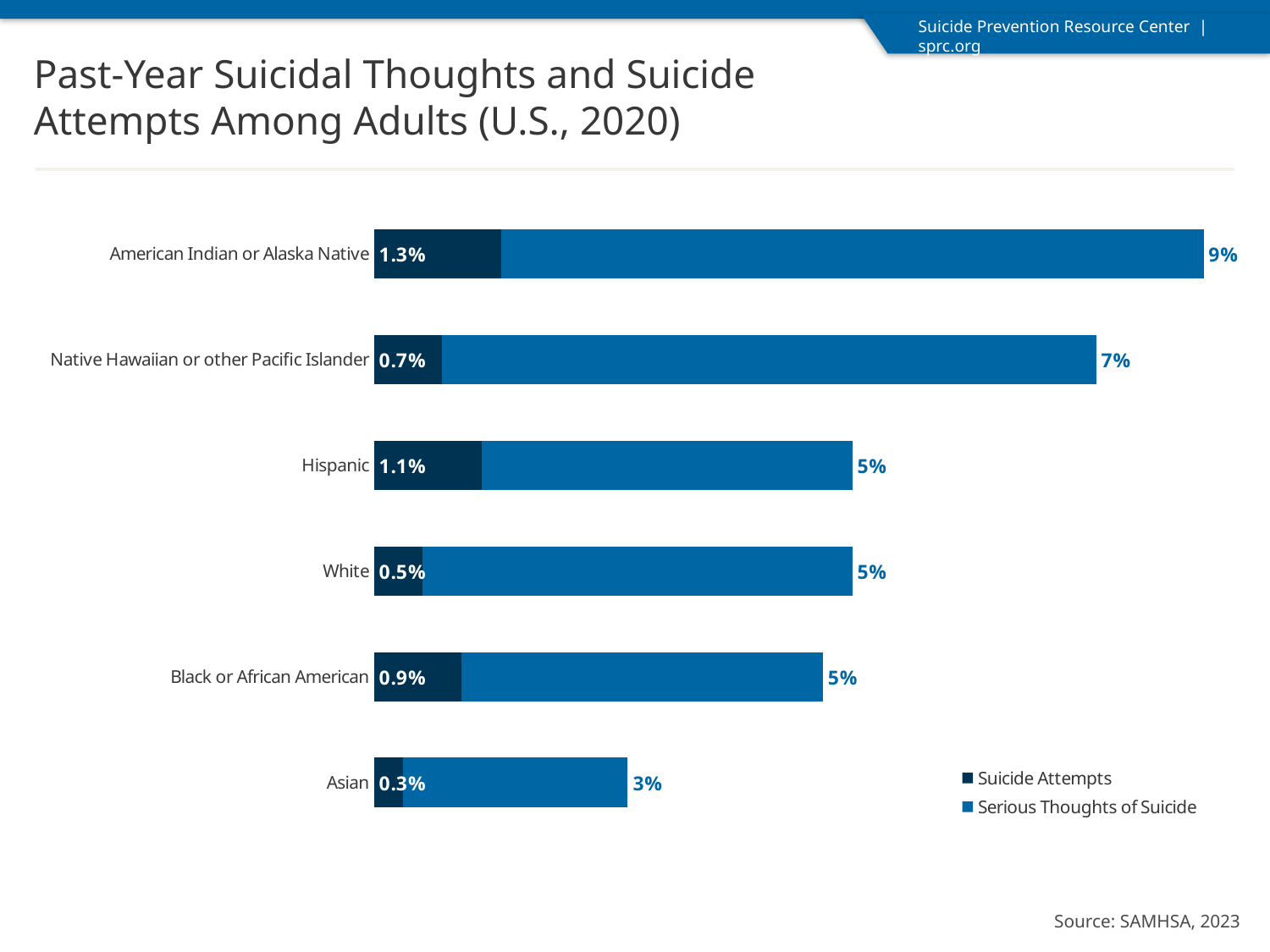
Which group has the highest Serious Thoughts of Suicide value? American Indian or Alaska Native How many racial/ethnic groups are shown in the chart? 6 What is the Serious Thoughts of Suicide value for Asian adults? 3% What is the Serious Thoughts of Suicide value for Native Hawaiian or other Pacific Islander adults? 7% What is the Suicide Attempts value for Black or African American adults? 0.9% What is the Suicide Attempts value for American Indian or Alaska Native adults? 1.3% Which is larger: the Suicide Attempts value for Native Hawaiian or other Pacific Islander adults or for Black or African American adults? Black or African American How many series does the legend list? 2 Which group has the lowest Suicide Attempts value? Asian What kind of chart is shown on the slide? Bar chart What is the difference between the Suicide Attempts values for Hispanic and White adults? 0.6% What is the difference between the Serious Thoughts of Suicide values for American Indian or Alaska Native and Asian adults? 6%